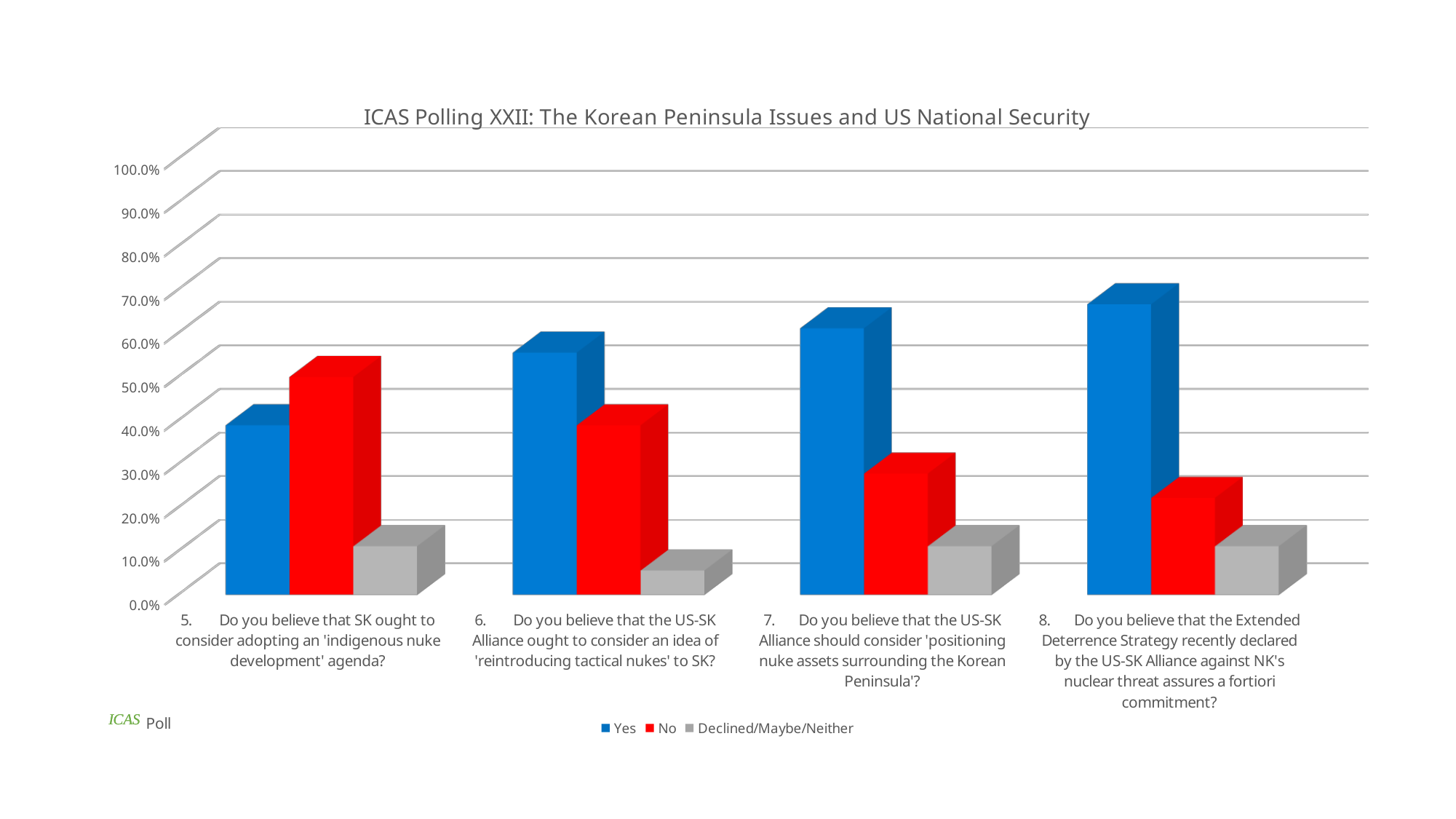
Which colour represents the 'No' series in the legend? red For question 5 (indigenous nuke development agenda), which is larger, the Yes value or the No value? No Do the Yes values rise or fall moving from question 5 to question 8 along the x axis? rise Is the Yes value for question 8 greater or less than 60.0%? greater How many series does the legend list? 3 What is the title of the chart? ICAS Polling XXII: The Korean Peninsula Issues and US National Security What kind of chart is shown on the slide? bar chart Is the Declined/Maybe/Neither value for question 6 greater or less than 10.0%? less For question 8 (Extended Deterrence Strategy), which is larger, the Yes value or the No value? Yes How many questions (categories) are plotted along the x axis? 4 Which question has the lowest Declined/Maybe/Neither value? 6. Do you believe that the US-SK Alliance ought to consider an idea of 'reintroducing tactical nukes' to SK? Which question has the highest Yes value? 8. Do you believe that the Extended Deterrence Strategy recently declared by the US-SK Alliance against NK's nuclear threat assures a fortiori commitment?